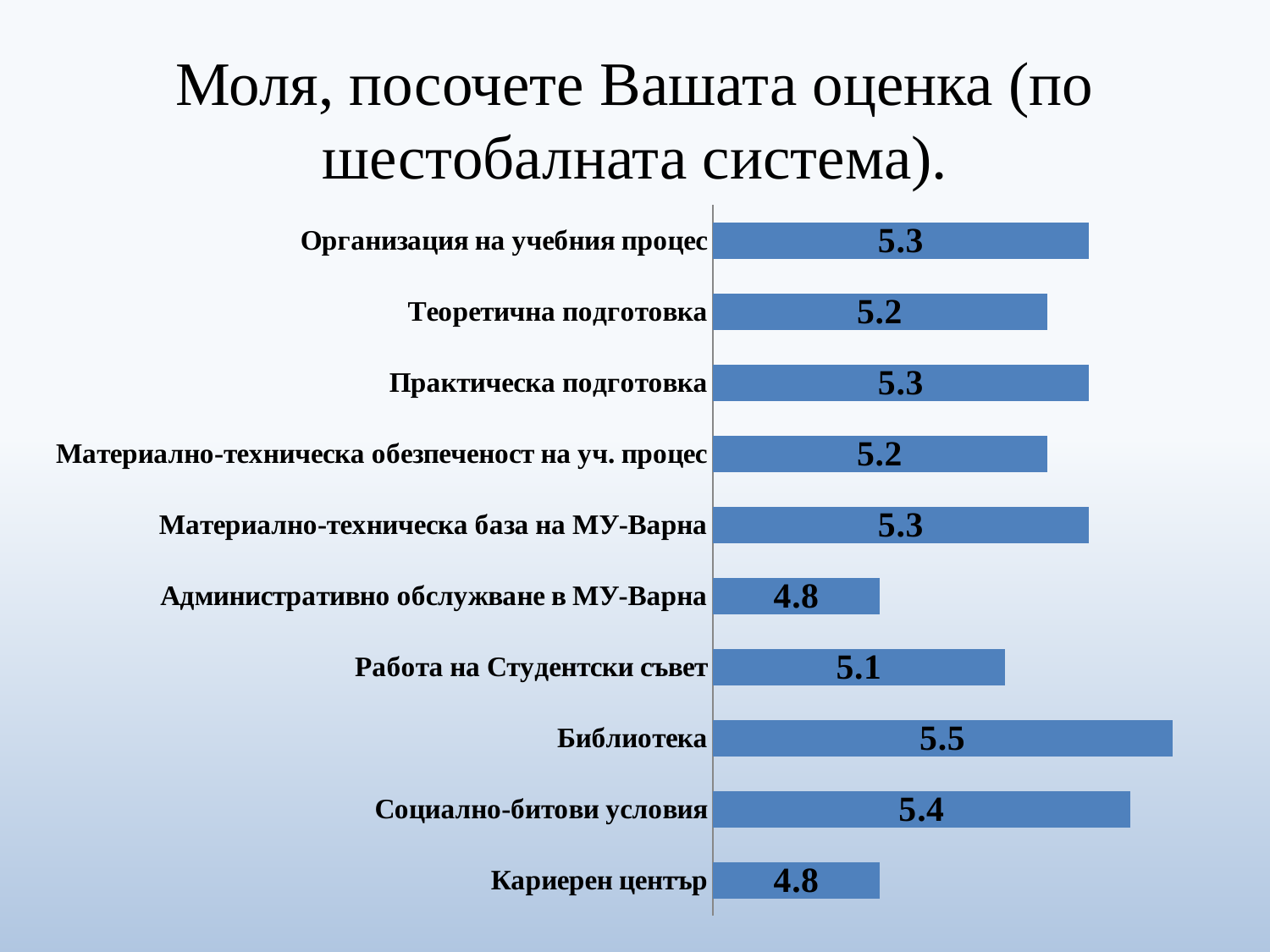
What is the difference between the values for Социално-битови условия and Работа на Студентски съвет? 0.3 What colour are the bars in the chart? Blue What is the value for Социално-битови условия? 5.4 What is the value for Библиотека? 5.5 How many categories are shown in the chart? 10 What kind of chart is shown on the slide? Bar chart What is the difference between the values for Библиотека and Кариерен център? 0.7 What is the value for Работа на Студентски съвет? 5.1 What is the value for Административно обслужване в МУ-Варна? 4.8 What is the value for Теоретична подготовка? 5.2 Which is larger, the value for Организация на учебния процес or the value for Административно обслужване в МУ-Варна? Организация на учебния процес Which category has the highest value? Библиотека